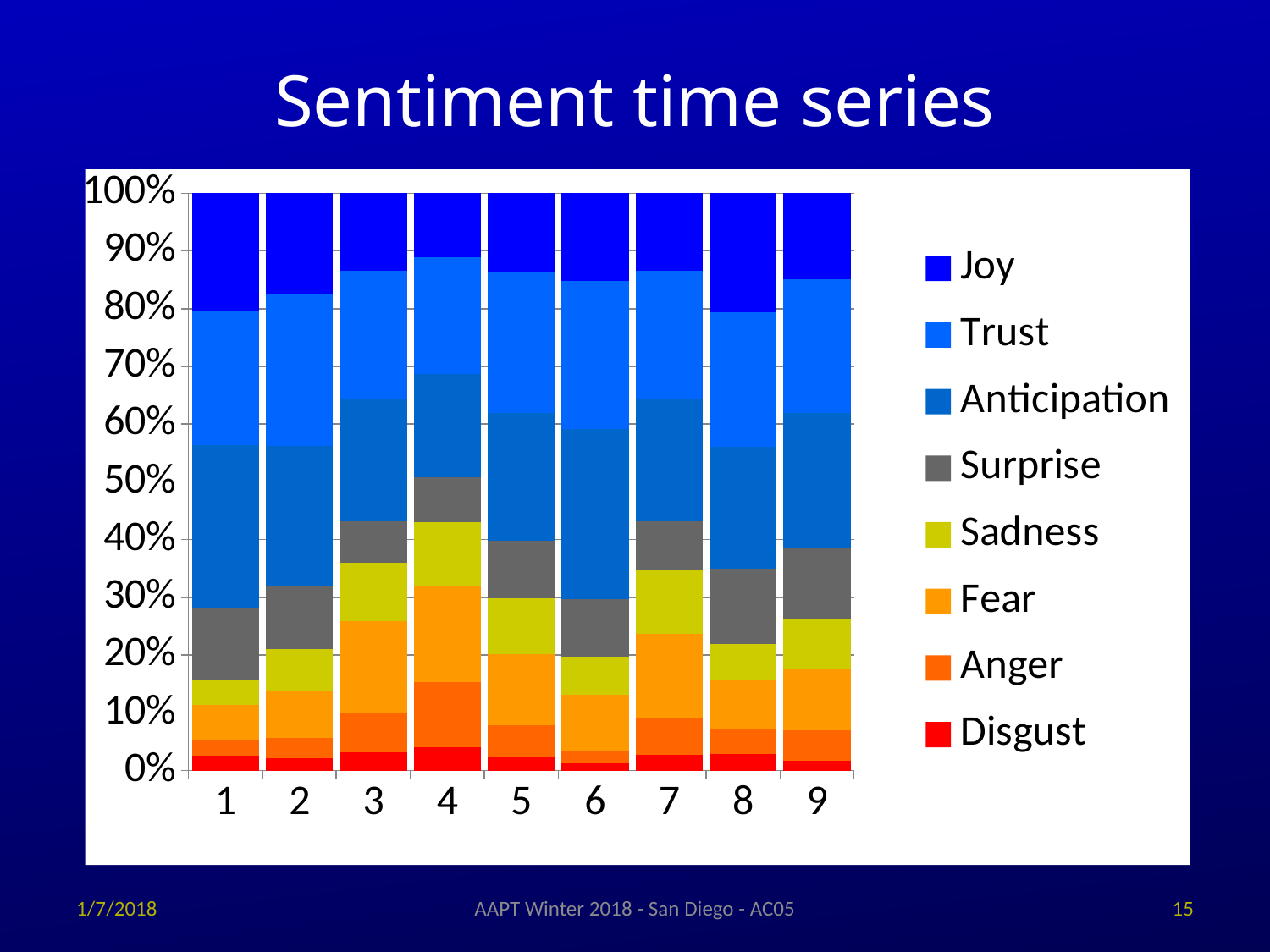
Is the Sadness share for category 1 greater or less than 10%? less What kind of chart is shown on the slide? stacked bar chart Is the Joy share for category 4 greater or less than 20%? less Which series is listed first in the legend? Joy How many series does the legend list? 8 Is the Fear share for category 4 greater or less than 10%? greater What is the title of the chart? Sentiment time series What is the total of the stacked bar for category 1? 100% How many categories are shown along the x axis? 9 Which has the larger Joy share, category 4 or category 8? category 8 Which has the larger Anticipation share, category 4 or category 6? category 6